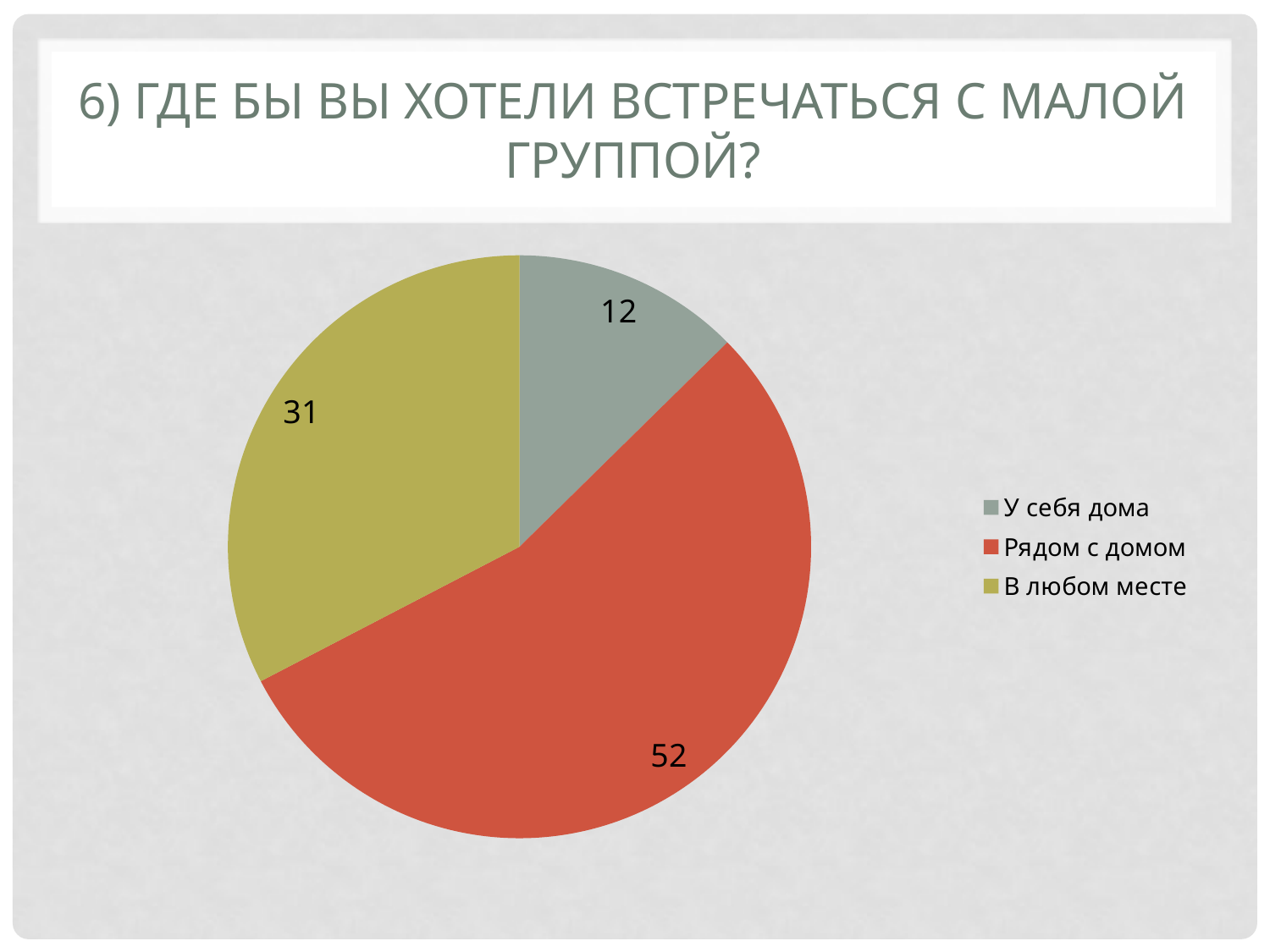
What is the difference between the values for "В любом месте" and "У себя дома"? 19 How many categories does the pie chart have? 3 Which category has the largest slice of the pie? Рядом с домом What is the value for "Рядом с домом"? 52 What is the value for "В любом месте"? 31 Which category has the smallest slice of the pie? У себя дома Which is larger, the value for "В любом месте" or the value for "У себя дома"? В любом месте What kind of chart is shown on the slide? pie chart What colour is the slice for "Рядом с домом"? red What is the value for "У себя дома"? 12 What is the total of all the values shown in the pie chart? 95 What is the difference between the values for "Рядом с домом" and "В любом месте"? 21